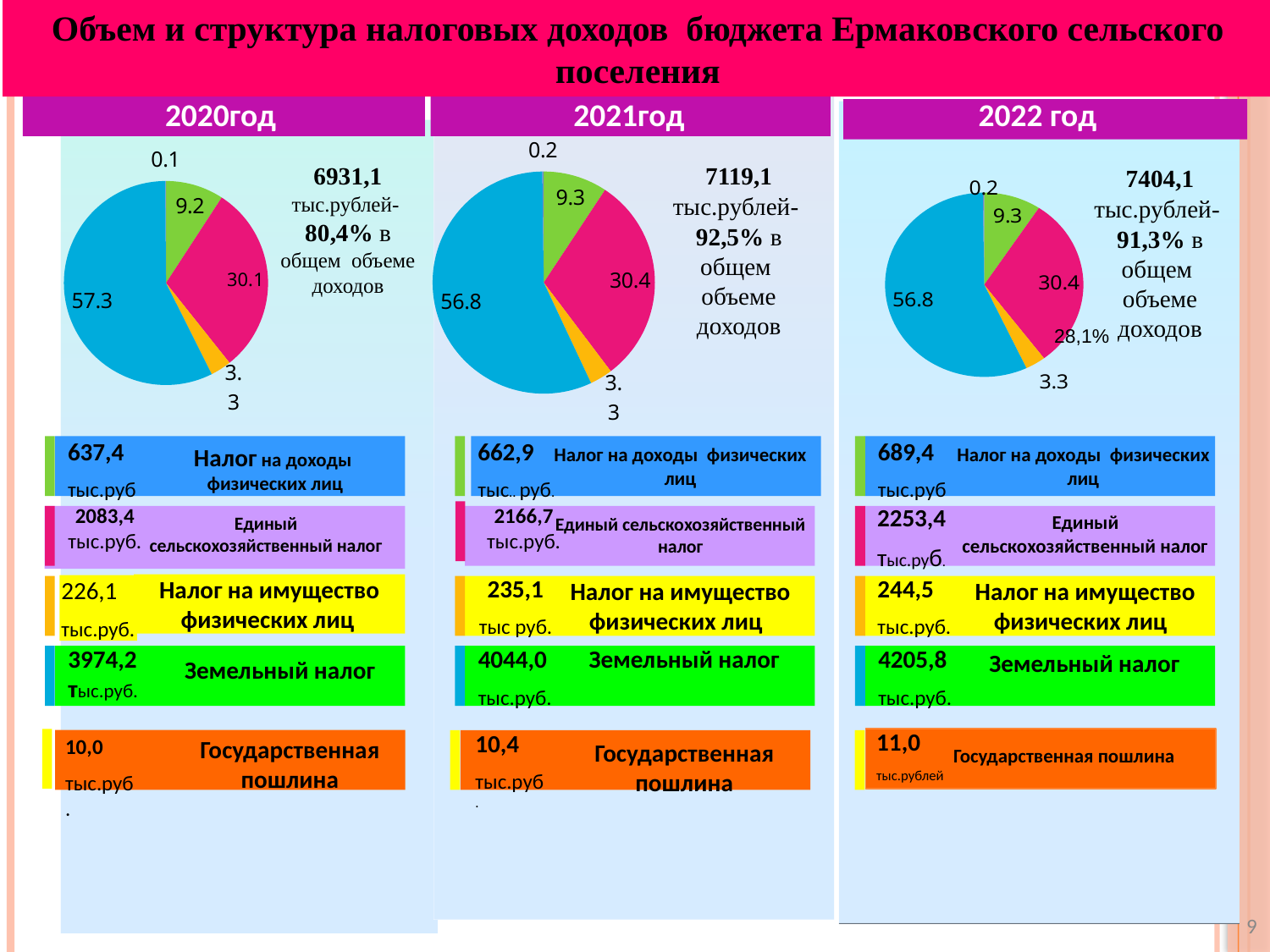
In the pie chart for 2020год, what is the value of the smallest slice? 0.1 How many slices does the pie chart for 2020год have? 5 What percentage share of total income is printed next to the pie chart for 2022 год? 91,3% In the pie chart for 2022 год, what value is labelled on the pink slice? 30.4 In the pie chart for 2021год, what value is labelled on the green slice? 9.3 What total amount in тыс.рублей is printed next to the pie chart for 2020год? 6931,1 What kind of chart is shown under the heading "2020год"? pie chart In the pie chart for 2020год, what is the difference between the blue slice (57.3) and the pink slice (30.1)? 27.2 In the pie chart for 2020год, what is the value of the largest slice? 57.3 In the pie chart for 2021год, which slice is larger, the blue one or the pink one? the blue one Which is larger: the green slice in the 2020год pie chart (9.2) or the green slice in the 2021год pie chart (9.3)? the 2021год green slice In the pie chart for 2022 год, what is the value of the smallest slice? 0.2